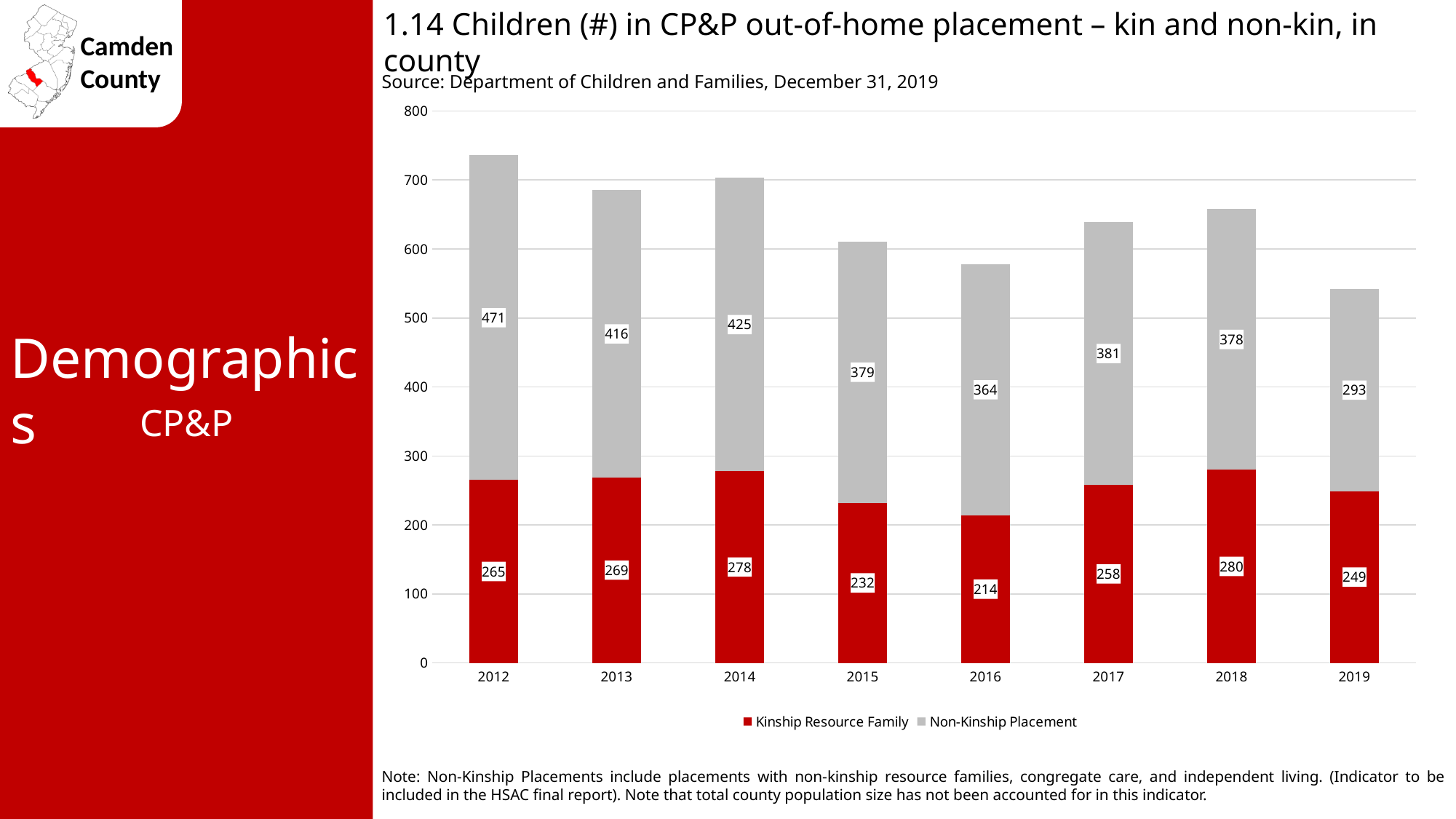
What is the difference between the Non-Kinship Placement values for 2012 and 2013? 55 Which year has the lowest Kinship Resource Family value? 2016 What is the Kinship Resource Family value for 2014? 278 Which year has the highest Non-Kinship Placement value? 2012 Is the total for 2012 greater or less than 700? greater How many years are shown on the x axis? 8 What is the total of the stacked bar for 2016? 578 What is the Non-Kinship Placement value for 2019? 293 What kind of chart is shown? Stacked bar chart How many series does the legend list? 2 What is the total of the stacked bar for 2019? 542 Which is larger: the Kinship Resource Family value for 2018 or for 2017? 2018